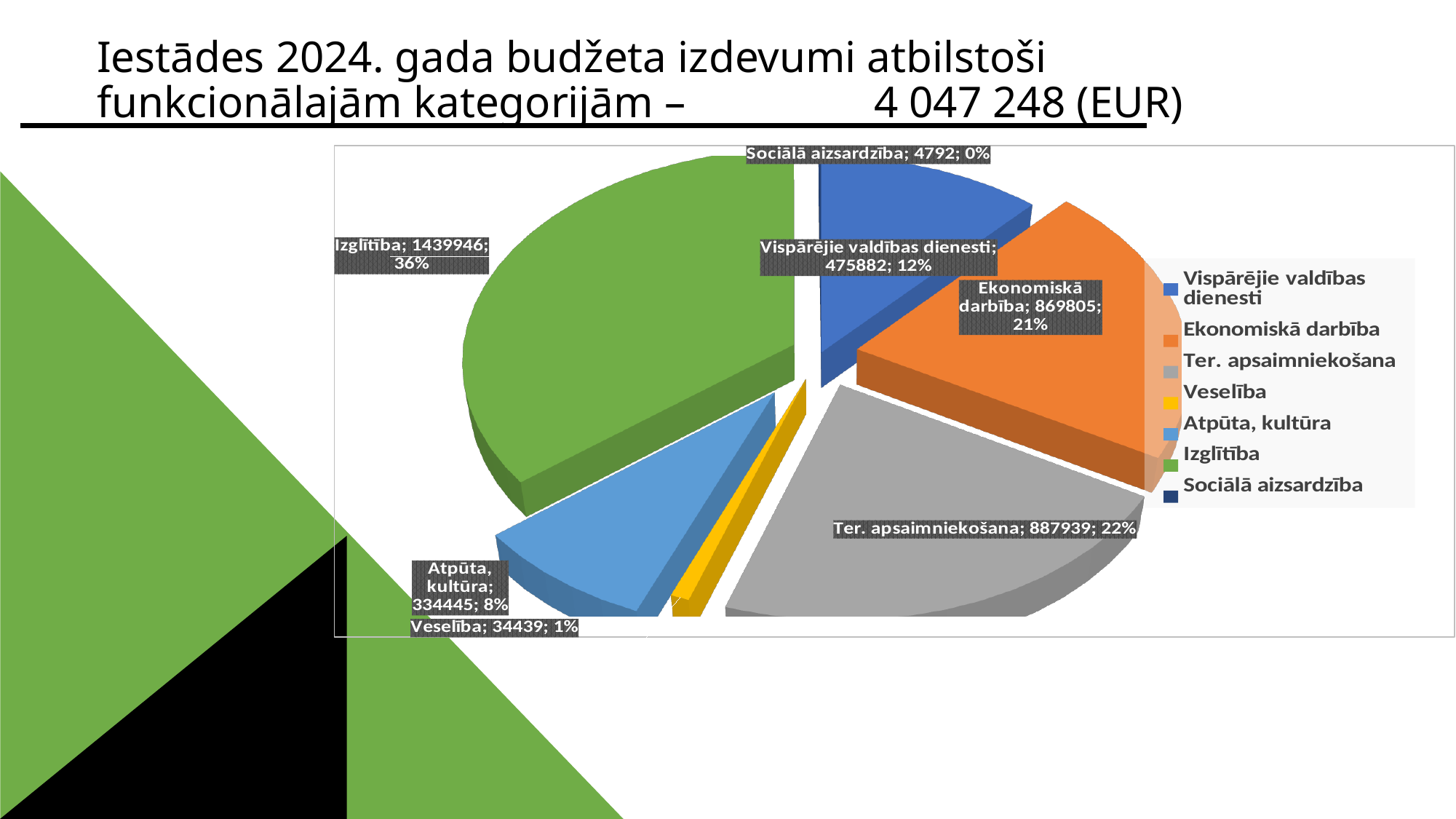
What is the value for Veselība? 34439 Which category has the smallest slice of the pie? Sociālā aizsardzība What colour is the Izglītība slice in the pie chart? green What is the value for Izglītība? 1439946 Which category has the largest slice of the pie? Izglītība What is the value for Ter. apsaimniekošana? 887939 What share of the pie does Ekonomiskā darbība represent? 21% What kind of chart is shown on the slide? pie chart What share of the pie does Vispārējie valdības dienesti represent? 12% How many categories does the pie chart show? 7 Which is larger, the value for Atpūta, kultūra or the value for Veselība? Atpūta, kultūra What is the difference between the values for Ter. apsaimniekošana and Ekonomiskā darbība? 18134